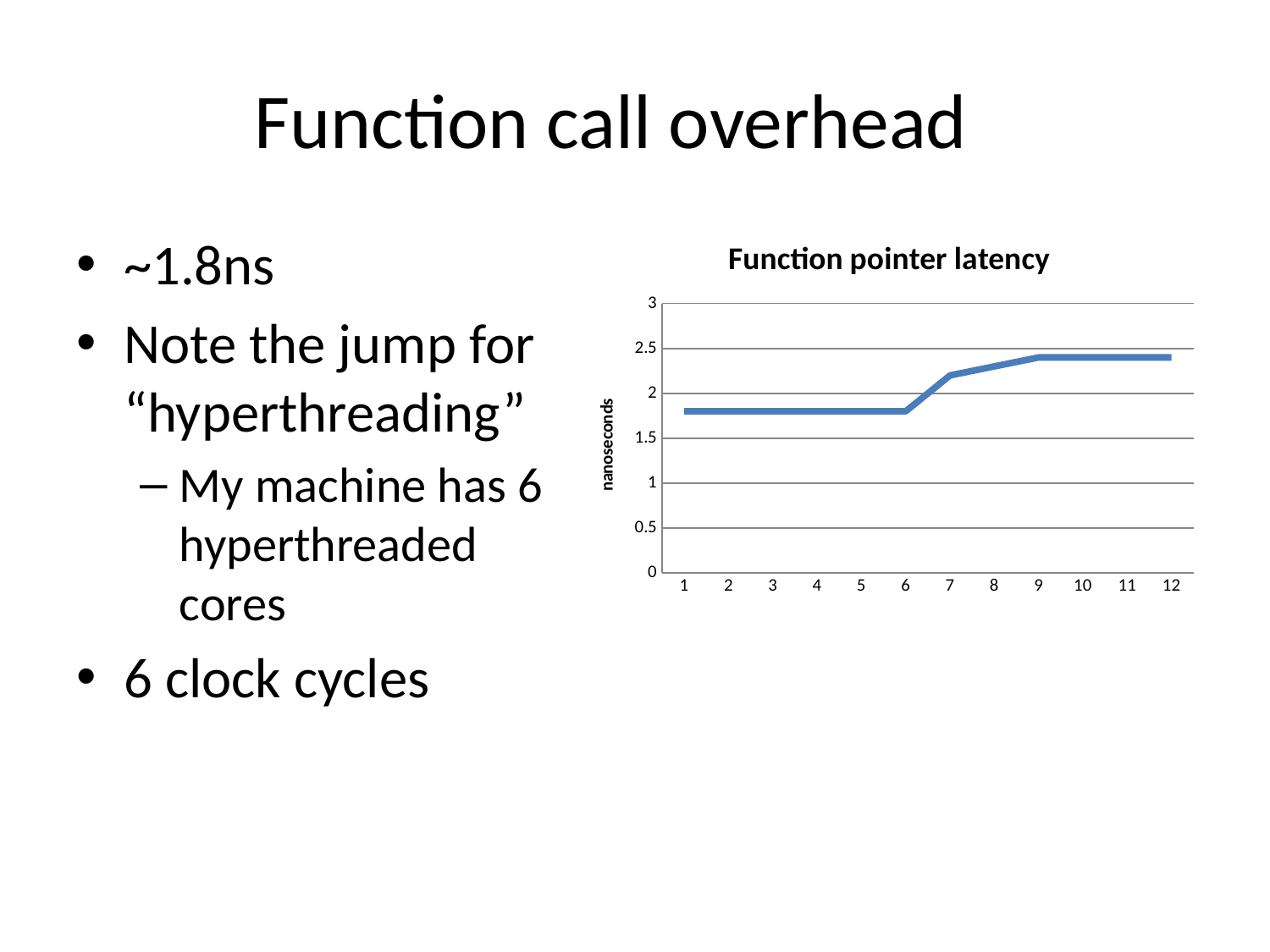
Is the value at x = 9 greater or less than 2? greater Do the values in the chart rise or fall as the x axis goes from 1 to 12? rise Is the value at x = 6 greater or less than 1.5? greater What is the title of the chart? Function pointer latency What is the label on the chart's vertical axis? nanoseconds Is the value at x = 12 greater or less than 2.5? less What kind of chart is shown on the slide? line chart Which has the larger value, x = 9 or x = 1? 9 Which has the larger value, x = 3 or x = 7? 7 How many data points are plotted along the x axis of the chart? 12